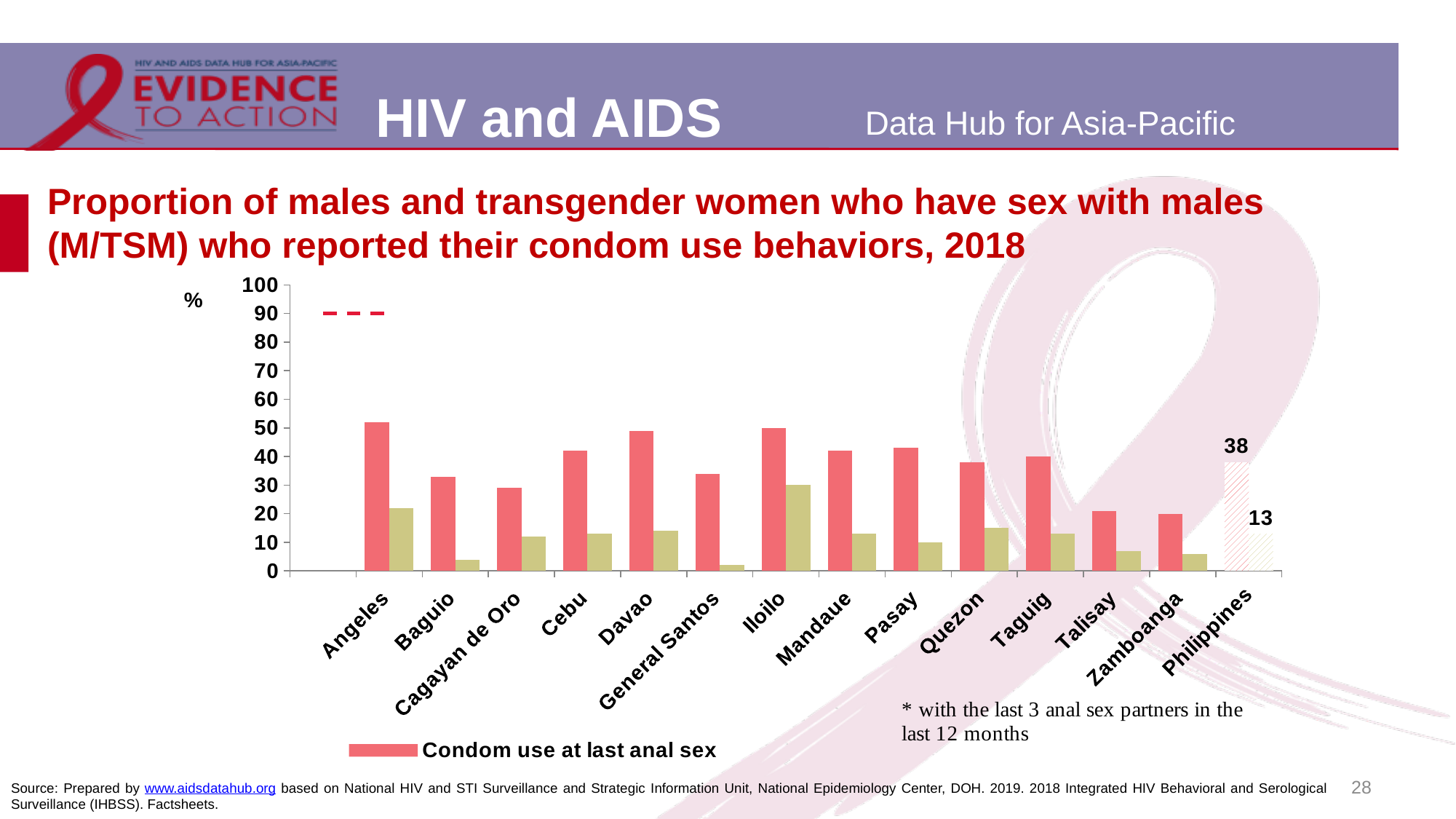
What is the difference between the two values shown for Philippines? 25 Which has the larger red bar, Cebu or Baguio? Cebu What is the label of the red series in the legend? Condom use at last anal sex Which has the larger red bar, Davao or Talisay? Davao What is the value of the red bar (condom use at last anal sex) for Philippines? 38 What kind of chart is shown on the slide? bar chart Which city has the highest olive (second series) bar? Iloilo Is the red bar for Angeles greater or less than 40? greater What is the value of the second (olive) bar for Philippines? 13 Is the olive bar for General Santos greater or less than 10? less How many categories are shown along the x axis of the chart? 14 Is the red bar for Baguio greater or less than 40? less